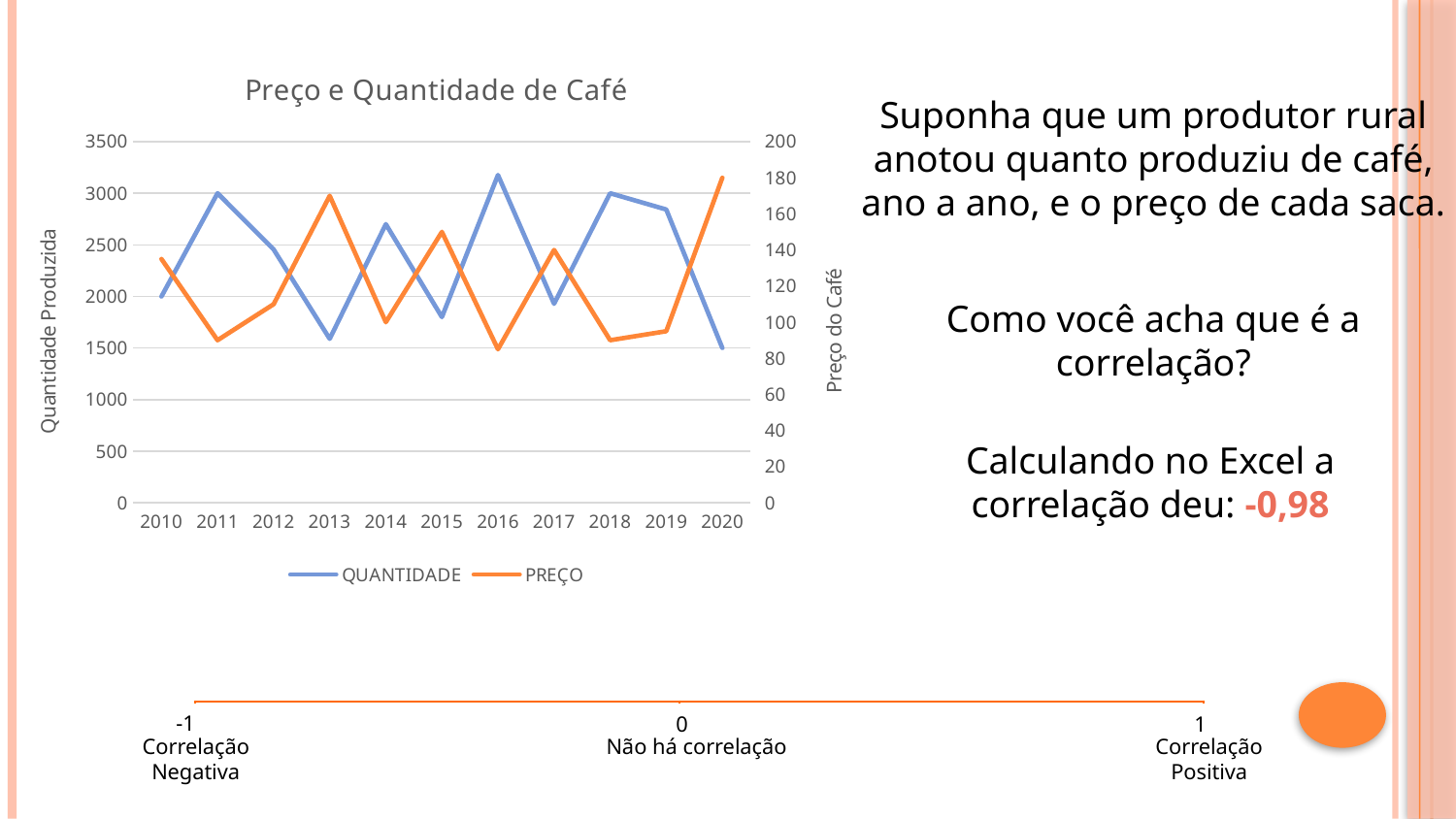
How many years are plotted along the x axis of the chart? 11 How many series does the chart legend list? 2 In which year is the QUANTIDADE series at its highest? 2016 Is the PREÇO value for 2013 greater or less than 140? greater Which year has the larger QUANTIDADE value, 2011 or 2013? 2011 Is the QUANTIDADE value for 2011 greater or less than 2500? greater Is the PREÇO value for 2016 greater or less than 100? less Which year has the larger PREÇO value, 2013 or 2014? 2013 What kind of chart is shown on the slide? Line chart Which series is drawn in orange in the chart? PREÇO What is the title of the chart? Preço e Quantidade de Café